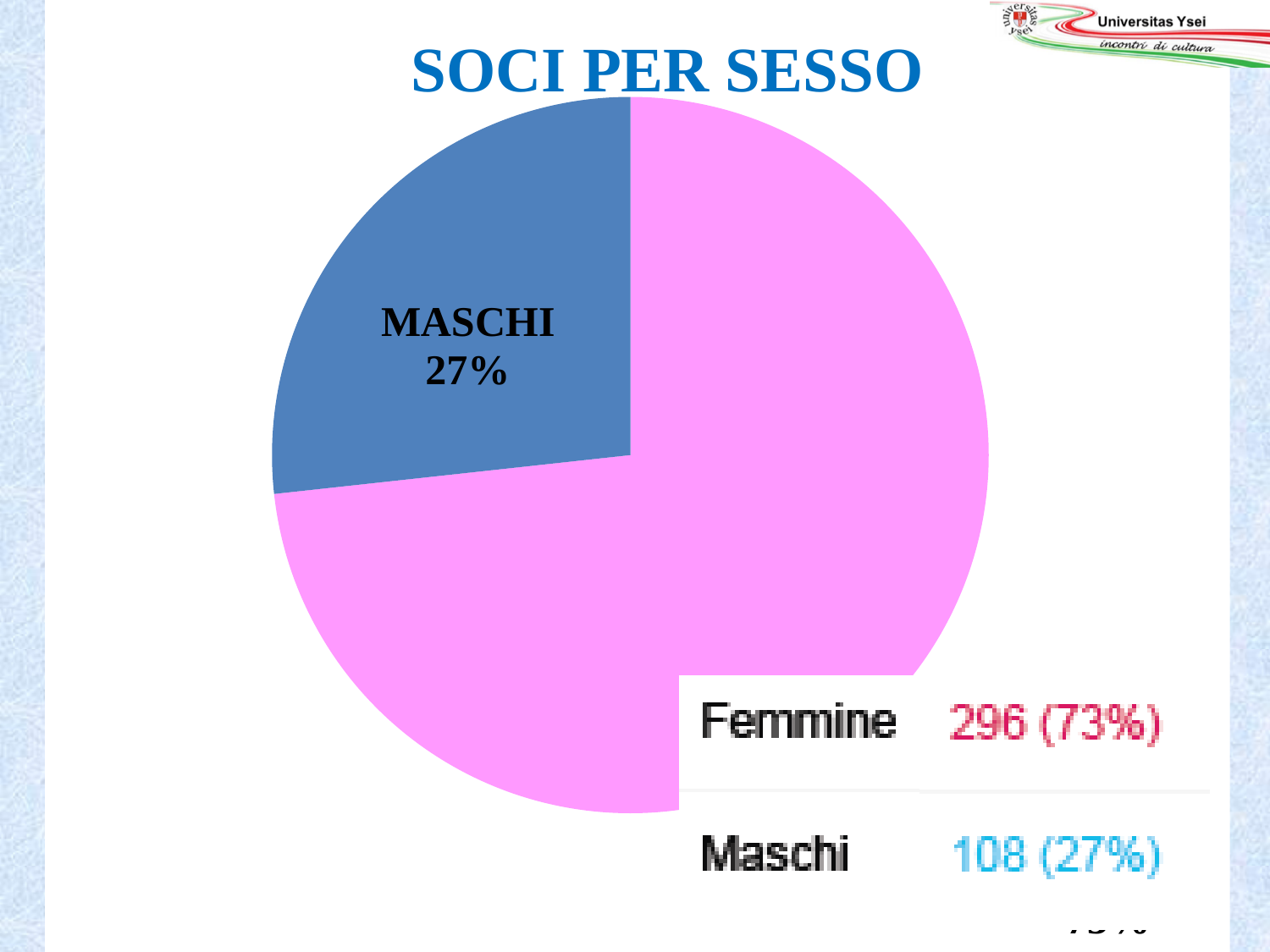
Which category has the smallest slice of the pie? Maschi How many Maschi are listed in the table on the slide? 108 What kind of chart is shown on the slide? pie chart How many Femmine are listed in the table on the slide? 296 How many slices does the pie chart have? 2 Which is larger, the Femmine slice or the Maschi slice? Femmine What is the difference between the number of Femmine and the number of Maschi? 188 What colour is the MASCHI slice of the pie? blue What percentage of the pie is labelled MASCHI? 27% What share of the pie does Femmine represent? 73% What is the title of the chart? SOCI PER SESSO Which category has the largest slice of the pie? Femmine